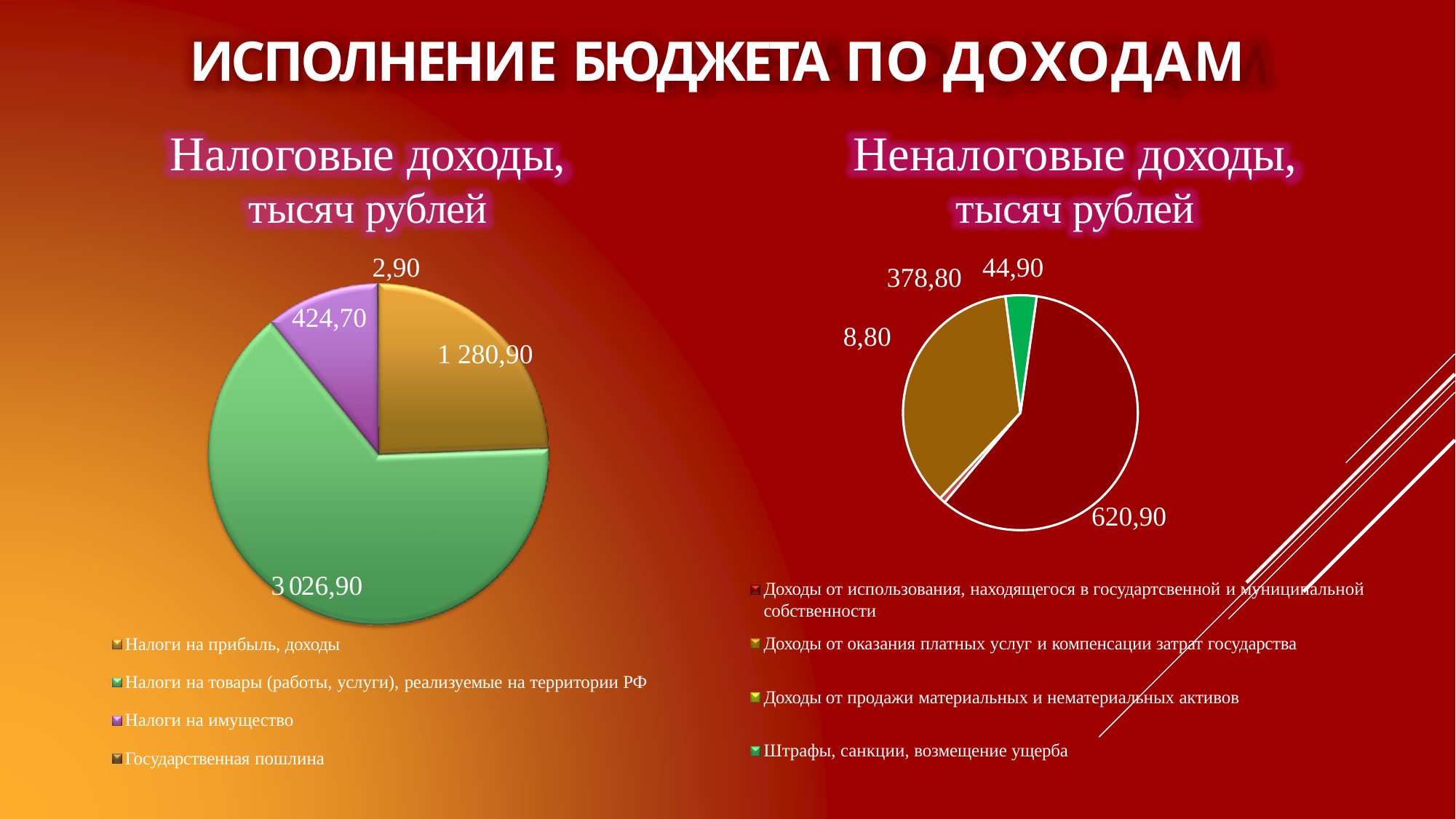
In the chart titled "Неналоговые доходы, тысяч рублей", what is the value for "Штрафы, санкции, возмещение ущерба"? 44,90 In the chart titled "Налоговые доходы, тысяч рублей", what is the difference between "Налоги на товары (работы, услуги), реализуемые на территории РФ" and "Налоги на прибыль, доходы"? 1 746,00 In the chart titled "Неналоговые доходы, тысяч рублей", which category has the largest value? Доходы от использования, находящегося в государтсвенной и муниципальной собственности In the chart titled "Налоговые доходы, тысяч рублей", what is the value for "Налоги на имущество"? 424,70 In the chart titled "Налоговые доходы, тысяч рублей", what is the value for "Налоги на товары (работы, услуги), реализуемые на территории РФ"? 3 026,90 In the chart titled "Неналоговые доходы, тысяч рублей", what is the difference between "Доходы от использования, находящегося в государтсвенной и муниципальной собственности" and "Доходы от оказания платных услуг и компенсации затрат государства"? 242,10 In the chart titled "Налоговые доходы, тысяч рублей", which category has the smallest value? Государственная пошлина In the chart titled "Налоговые доходы, тысяч рублей", which category has the largest value? Налоги на товары (работы, услуги), реализуемые на территории РФ In the chart titled "Налоговые доходы, тысяч рублей", how many categories are shown? 4 In the chart titled "Неналоговые доходы, тысяч рублей", which is larger: "Штрафы, санкции, возмещение ущерба" or "Доходы от продажи материальных и нематериальных активов"? Штрафы, санкции, возмещение ущерба In the chart titled "Неналоговые доходы, тысяч рублей", what is the value for "Доходы от оказания платных услуг и компенсации затрат государства"? 378,80 What type of chart is the chart titled "Неналоговые доходы, тысяч рублей"? Pie chart